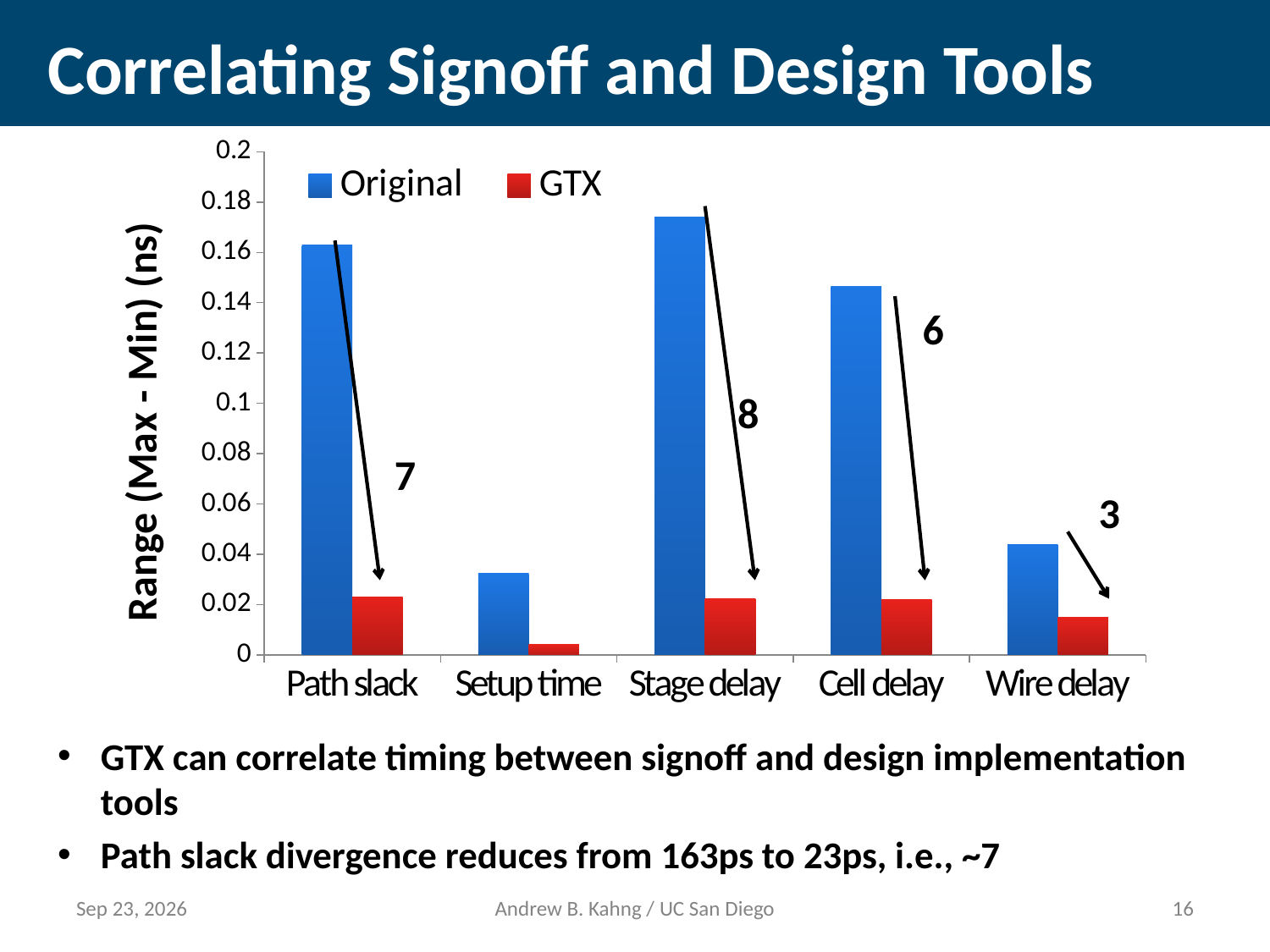
Is the GTX value for Setup time greater or less than 0.02? less How many series does the legend list? 2 What is the label on the y axis? Range (Max - Min) (ns) Which category has the highest Original value? Stage delay Which category has the lowest Original value? Setup time Is the Original value for Wire delay greater or less than 0.06? less Which is larger for Cell delay, the Original value or the GTX value? Original Is the Original value for Path slack greater or less than 0.14? greater How many categories are shown on the x axis? 5 Which colour represents the GTX series? red What kind of chart is shown on the slide? bar chart Which category has the lowest GTX value? Setup time